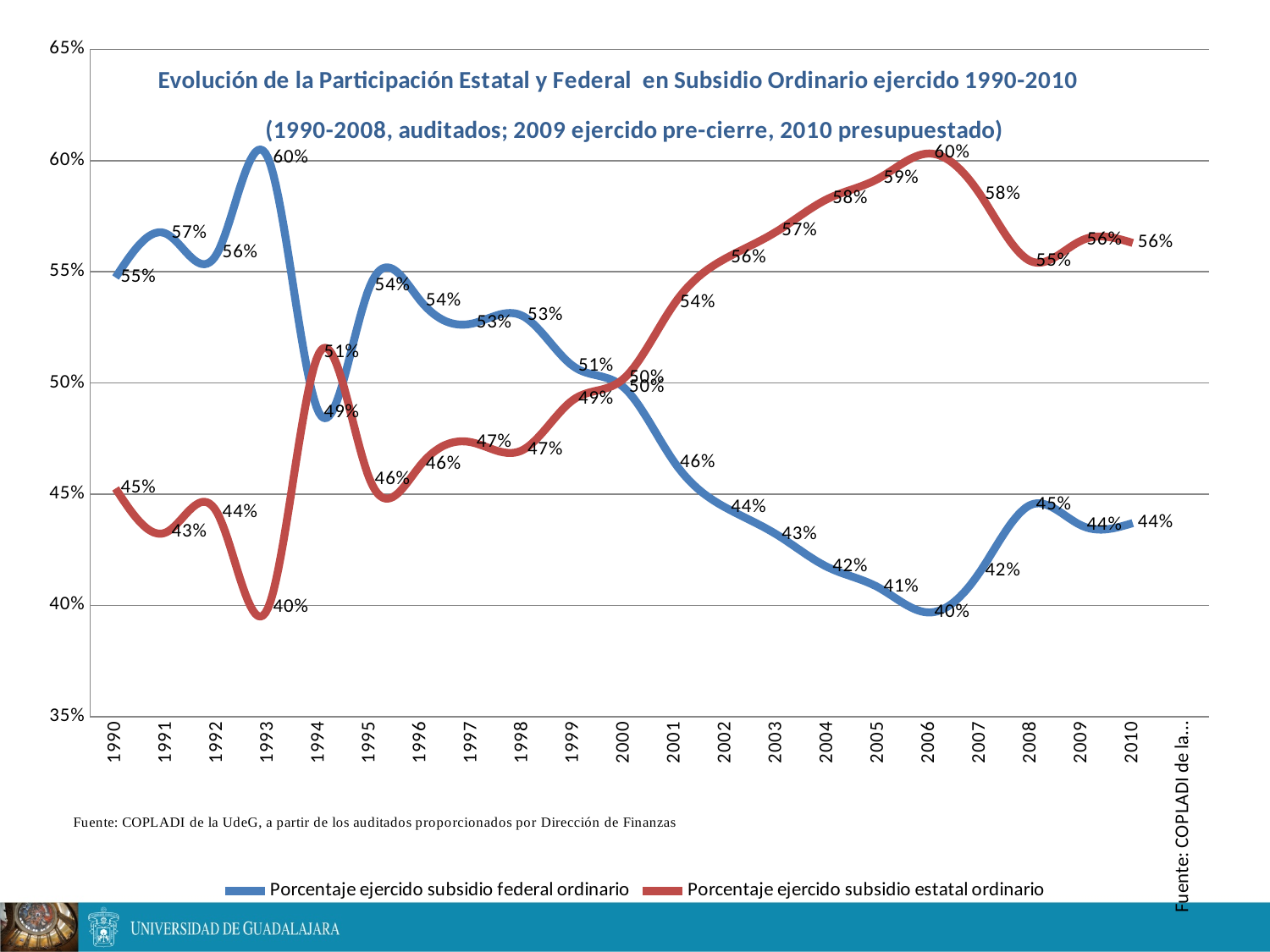
How many years are shown on the x axis? 21 In which year does Porcentaje ejercido subsidio federal ordinario reach its lowest value? 2006 Which series has the higher value in 2004, federal or estatal? Porcentaje ejercido subsidio estatal ordinario What is the value of Porcentaje ejercido subsidio estatal ordinario in 1990? 45% What kind of chart is shown on the slide? Line chart How many series does the legend list? 2 In which year does Porcentaje ejercido subsidio estatal ordinario reach its lowest value? 1993 What is the difference between the federal and estatal percentages in 1993? 20 percentage points What is the value of Porcentaje ejercido subsidio federal ordinario in 2010? 44% What is the value of Porcentaje ejercido subsidio estatal ordinario in 2006? 60% What is the value of Porcentaje ejercido subsidio federal ordinario in 1993? 60% Does Porcentaje ejercido subsidio estatal ordinario rise or fall from 2000 to 2006? Rise